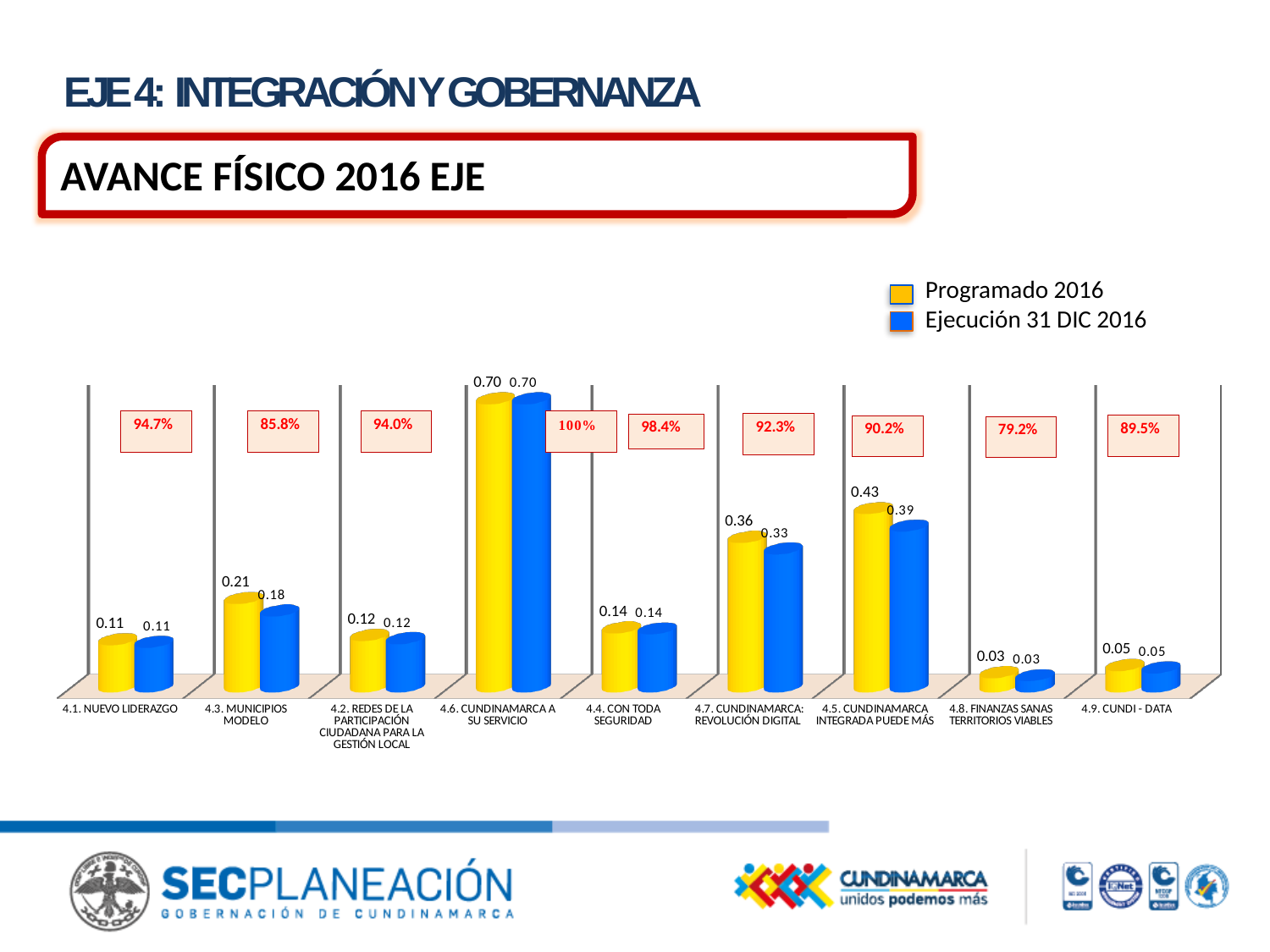
What is the Programado 2016 value for 4.5. CUNDINAMARCA INTEGRADA PUEDE MÁS? 0.43 What percentage is shown in the box above 4.8. FINANZAS SANAS TERRITORIOS VIABLES? 79.2% Which is larger, the Programado 2016 value for 4.3. MUNICIPIOS MODELO or for 4.4. CON TODA SEGURIDAD? 4.3. MUNICIPIOS MODELO What is the Ejecución 31 DIC 2016 value for 4.7. CUNDINAMARCA: REVOLUCIÓN DIGITAL? 0.33 How many series does the chart legend list? 2 Which category has the highest Programado 2016 value? 4.6. CUNDINAMARCA A SU SERVICIO What is the difference between the Programado 2016 and Ejecución 31 DIC 2016 values for 4.5. CUNDINAMARCA INTEGRADA PUEDE MÁS? 0.04 What is the Ejecución 31 DIC 2016 value for 4.3. MUNICIPIOS MODELO? 0.18 Which category has the lowest Ejecución 31 DIC 2016 value? 4.8. FINANZAS SANAS TERRITORIOS VIABLES What is the difference between the Programado 2016 values for 4.6. CUNDINAMARCA A SU SERVICIO and 4.7. CUNDINAMARCA: REVOLUCIÓN DIGITAL? 0.34 How many categories are shown on the x axis of the chart? 9 What kind of chart is shown on the slide? Bar chart